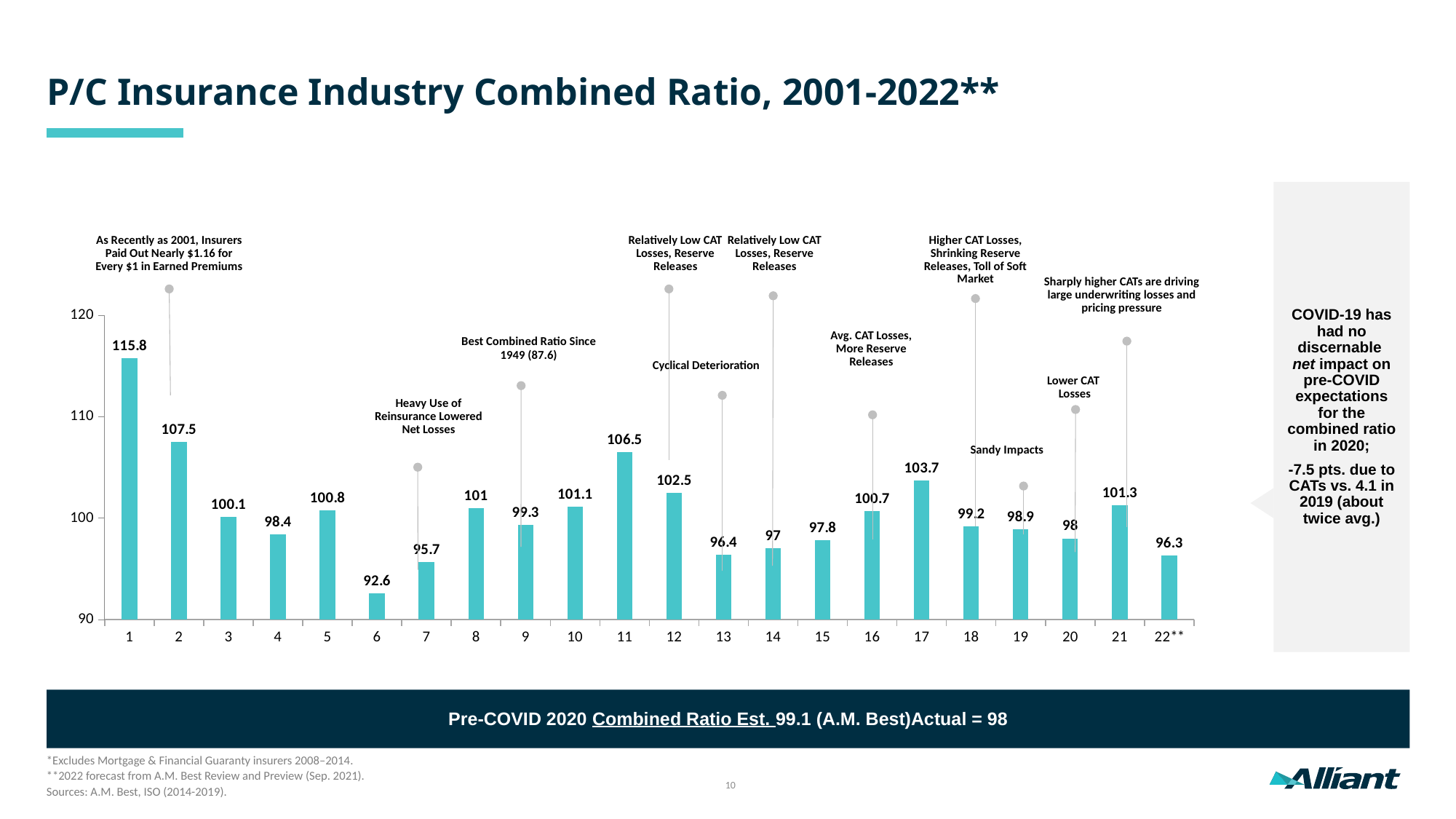
Which x-axis category has the lowest combined ratio? 6 What value is shown for the bar labeled 22**? 96.3 Is the value for the bar labeled 6 greater or less than 100? less What is the title of the chart on the slide? P/C Insurance Industry Combined Ratio, 2001-2022** Which x-axis category has the highest combined ratio? 1 What kind of chart is shown on the slide? bar chart What value is printed above the bar labeled 11? 106.5 Which is larger, the value for the bar labeled 17 or the bar labeled 12? 17 What is the combined ratio value shown for the bar labeled 1 on the x axis? 115.8 What is the difference between the values for the bars labeled 1 and 2? 8.3 How many bars are plotted in the chart? 22 What is the difference between the values for the bars labeled 20 and 21? 3.3